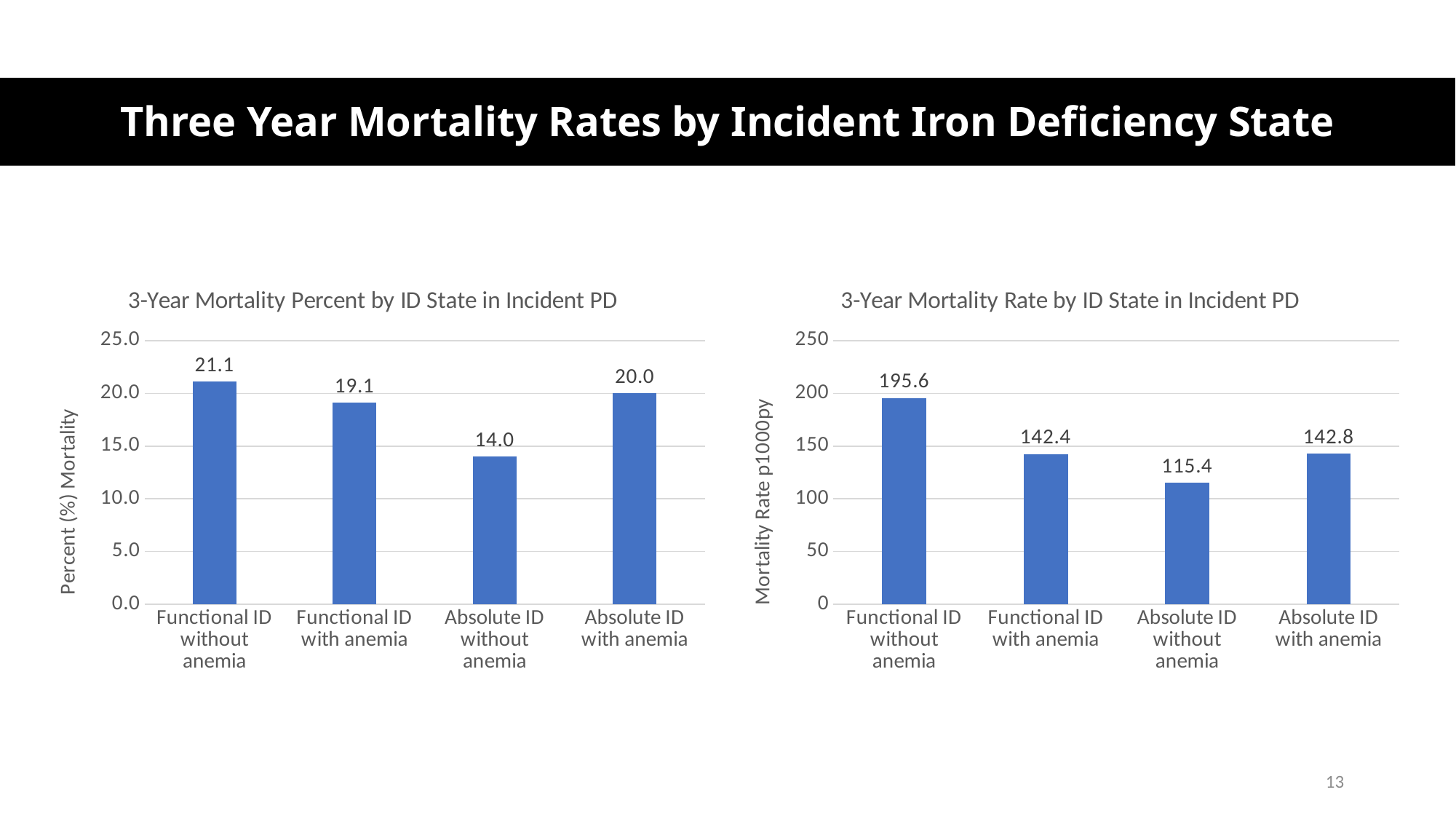
In the chart titled '3-Year Mortality Percent by ID State in Incident PD', what is the value for Absolute ID without anemia? 14.0 In the chart titled '3-Year Mortality Rate by ID State in Incident PD', which category has the lowest value? Absolute ID without anemia In the chart titled '3-Year Mortality Percent by ID State in Incident PD', what is the difference between Functional ID without anemia and Absolute ID without anemia? 7.1 How many categories are shown in the chart titled '3-Year Mortality Rate by ID State in Incident PD'? 4 In the chart titled '3-Year Mortality Percent by ID State in Incident PD', which is larger: Functional ID with anemia or Absolute ID with anemia? Absolute ID with anemia In the chart titled '3-Year Mortality Rate by ID State in Incident PD', what is the difference between Functional ID without anemia and Functional ID with anemia? 53.2 In the chart titled '3-Year Mortality Percent by ID State in Incident PD', what is the value for Functional ID without anemia? 21.1 In the chart titled '3-Year Mortality Rate by ID State in Incident PD', is the value for Absolute ID without anemia greater or less than 150? less In the chart titled '3-Year Mortality Percent by ID State in Incident PD', which category has the highest value? Functional ID without anemia In the chart titled '3-Year Mortality Rate by ID State in Incident PD', what is the value for Absolute ID with anemia? 142.8 What kind of chart is the chart titled '3-Year Mortality Percent by ID State in Incident PD'? Bar chart In the chart titled '3-Year Mortality Rate by ID State in Incident PD', what is the value for Functional ID without anemia? 195.6